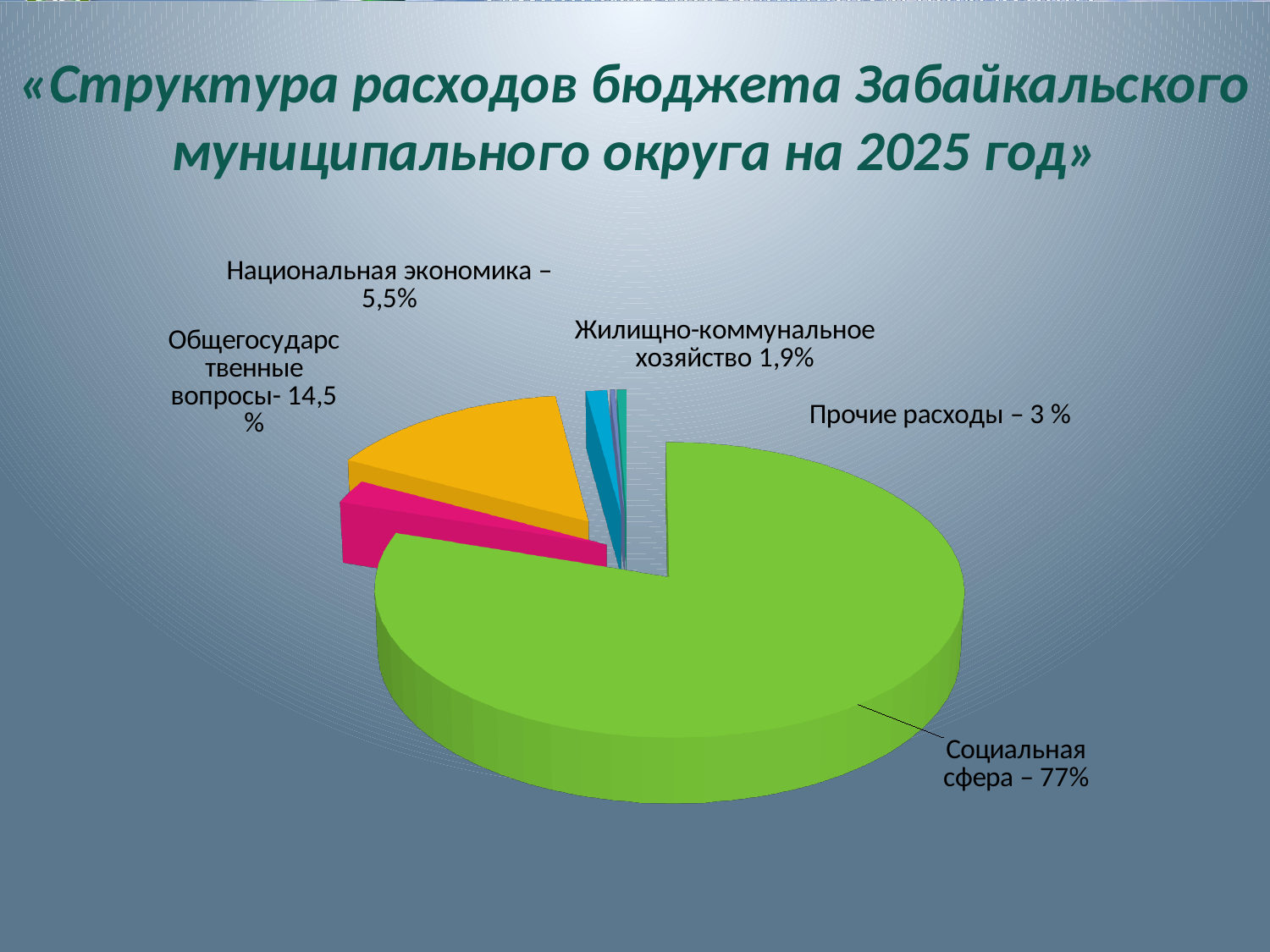
What share of the budget expenditure goes to Социальная сфера? 77% Which is larger, the share for Национальная экономика or the share for Прочие расходы? Национальная экономика What is the value shown for Общегосударственные вопросы? 14,5 % What is the value shown for Национальная экономика? 5,5% Which category has the largest share of the pie? Социальная сфера What is the difference between the shares for Общегосударственные вопросы and Национальная экономика? 9 percentage points What is the value shown for Жилищно-коммунальное хозяйство? 1,9% What is the value shown for Прочие расходы? 3 % What kind of chart is shown on the slide? pie chart What colour is the slice for Социальная сфера? green Which category has the smallest share of the pie? Жилищно-коммунальное хозяйство